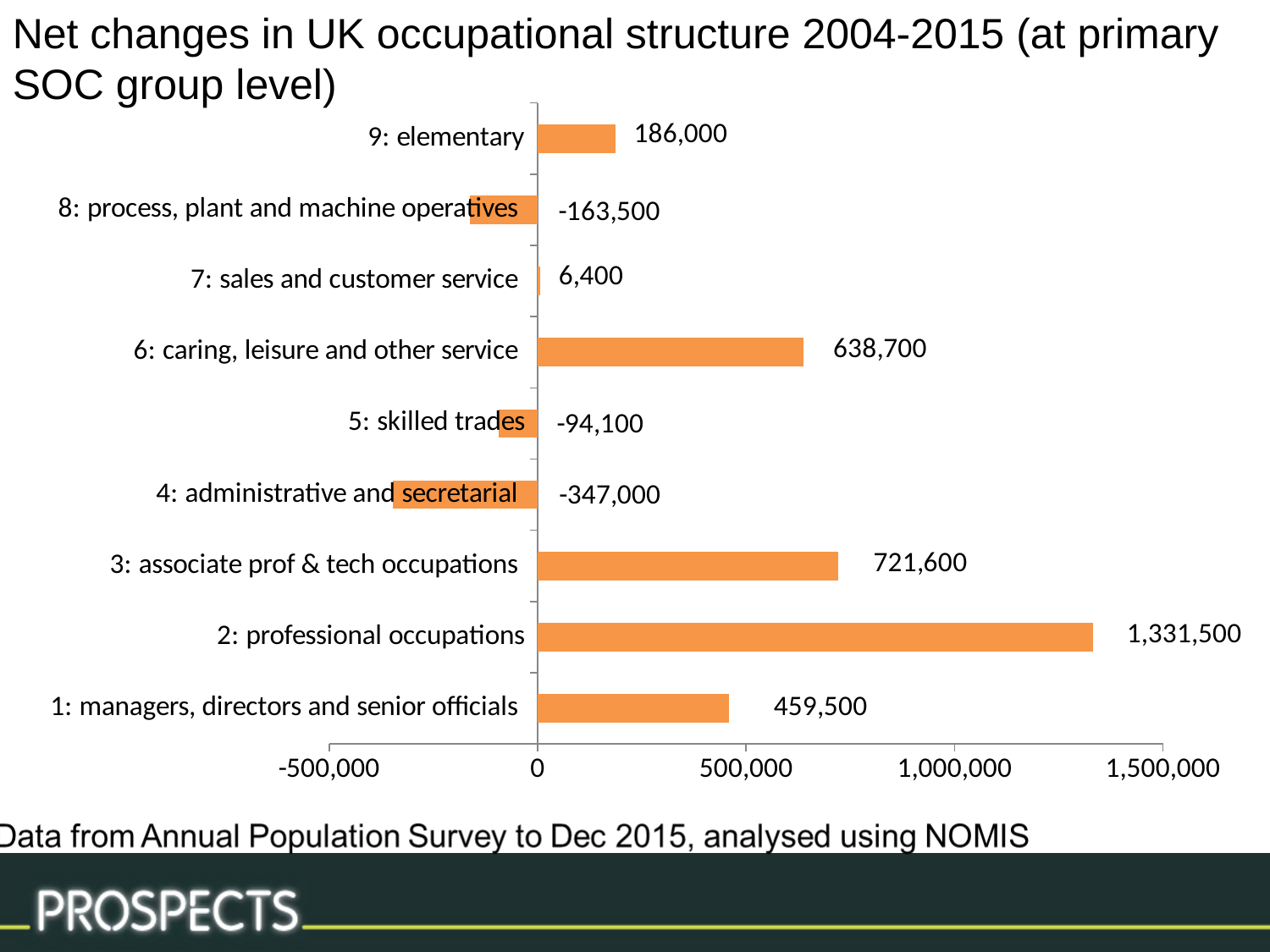
What is the net change for 7: sales and customer service? 6,400 What is the net change for 4: administrative and secretarial? -347,000 What is the net change for 9: elementary? 186,000 Is the net change for 8: process, plant and machine operatives greater or less than 0? less What is the net change for 2: professional occupations? 1,331,500 What type of chart is shown on the slide? bar chart Which occupational group has the lowest net change? 4: administrative and secretarial What is the difference between the net change for 3: associate prof & tech occupations and 6: caring, leisure and other service? 82,900 Which has a larger net change, 1: managers, directors and senior officials or 6: caring, leisure and other service? 6: caring, leisure and other service What is the title of the chart? Net changes in UK occupational structure 2004-2015 (at primary SOC group level) Which occupational group has the highest net change? 2: professional occupations How many occupational groups are shown in the chart? 9